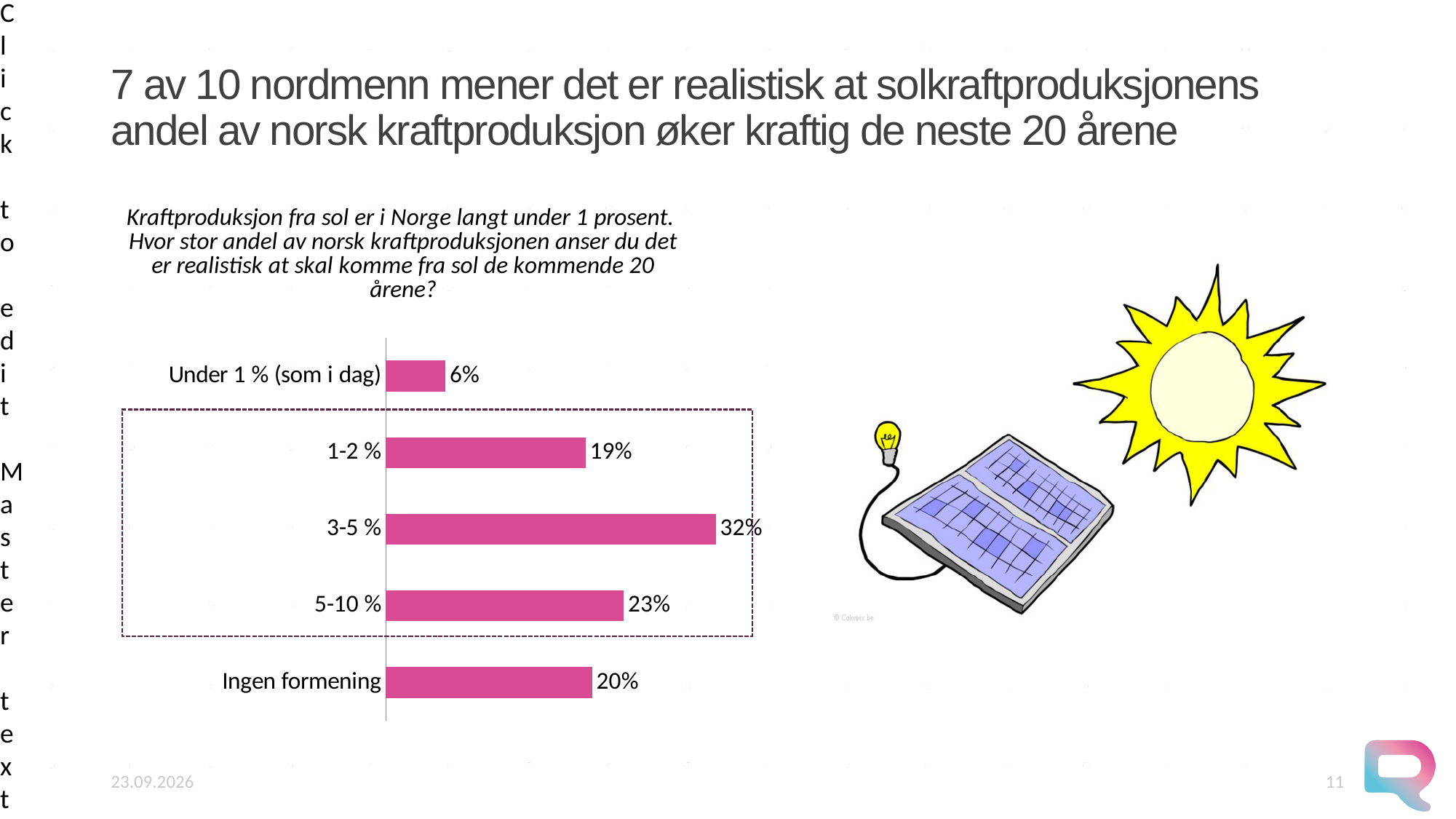
What kind of chart is shown on the slide? Bar chart What is the value for 'Under 1 % (som i dag)'? 6% What is the difference between the values for '3-5 %' and '1-2 %'? 13% Which category has the lowest value? Under 1 % (som i dag) What is the value for '5-10 %'? 23% What is the value for '3-5 %'? 32% What colour are the bars in the chart? Pink What is the value for 'Ingen formening'? 20% Which is larger, the value for '5-10 %' or the value for 'Ingen formening'? 5-10 % Which category has the highest value? 3-5 % How many categories are shown in the chart? 5